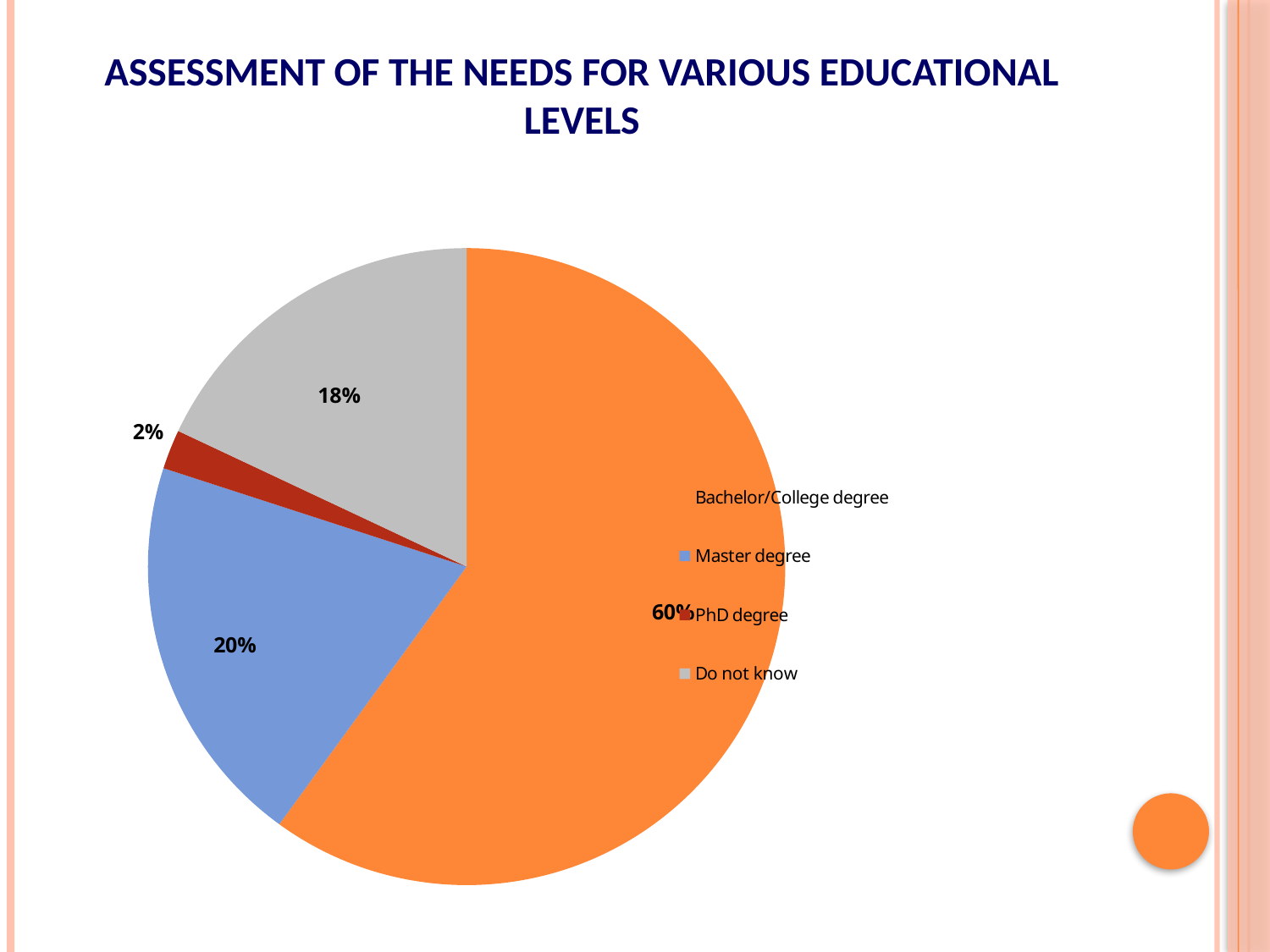
What is the difference in percentage points between Bachelor/College degree and Master degree? 40 Which category has the largest slice of the pie? Bachelor/College degree What share of the pie does PhD degree have? 2% How many slices does the pie chart have? 4 Which category has the smallest slice of the pie? PhD degree Which is larger, the slice for Master degree or the slice for Do not know? Master degree What share of the pie does Master degree have? 20% What share of the pie does Do not know have? 18% What is the difference in percentage points between Master degree and Do not know? 2 What colour is the slice for Do not know? grey What kind of chart is shown on the slide? pie chart What share of the pie does Bachelor/College degree have? 60%